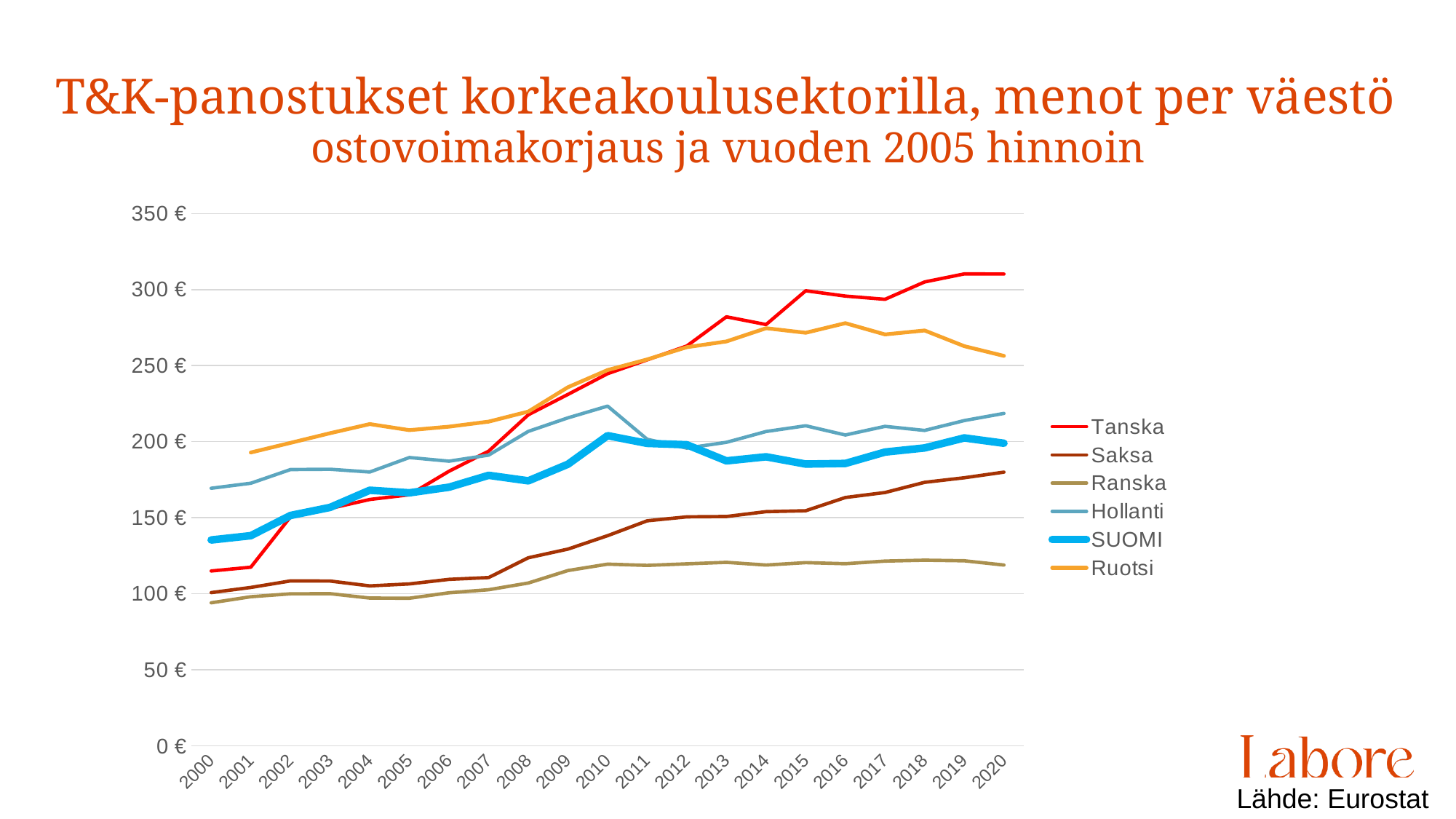
Which country has the highest value in 2020? Tanska Is the value for SUOMI in 2000 greater or less than 150 €? less What source is cited for the data on the slide? Eurostat Is the value for Saksa in 2020 greater or less than 150 €? greater Does the value for Tanska rise or fall from 2000 to 2020? rise Is the value for Ruotsi in 2016 greater or less than 250 €? greater In 2020, which is larger, the value for Hollanti or the value for SUOMI? Hollanti How many series does the legend list? 6 Which country has the lowest value in 2020? Ranska What kind of chart is shown on the slide? line chart How many years are shown along the x axis? 21